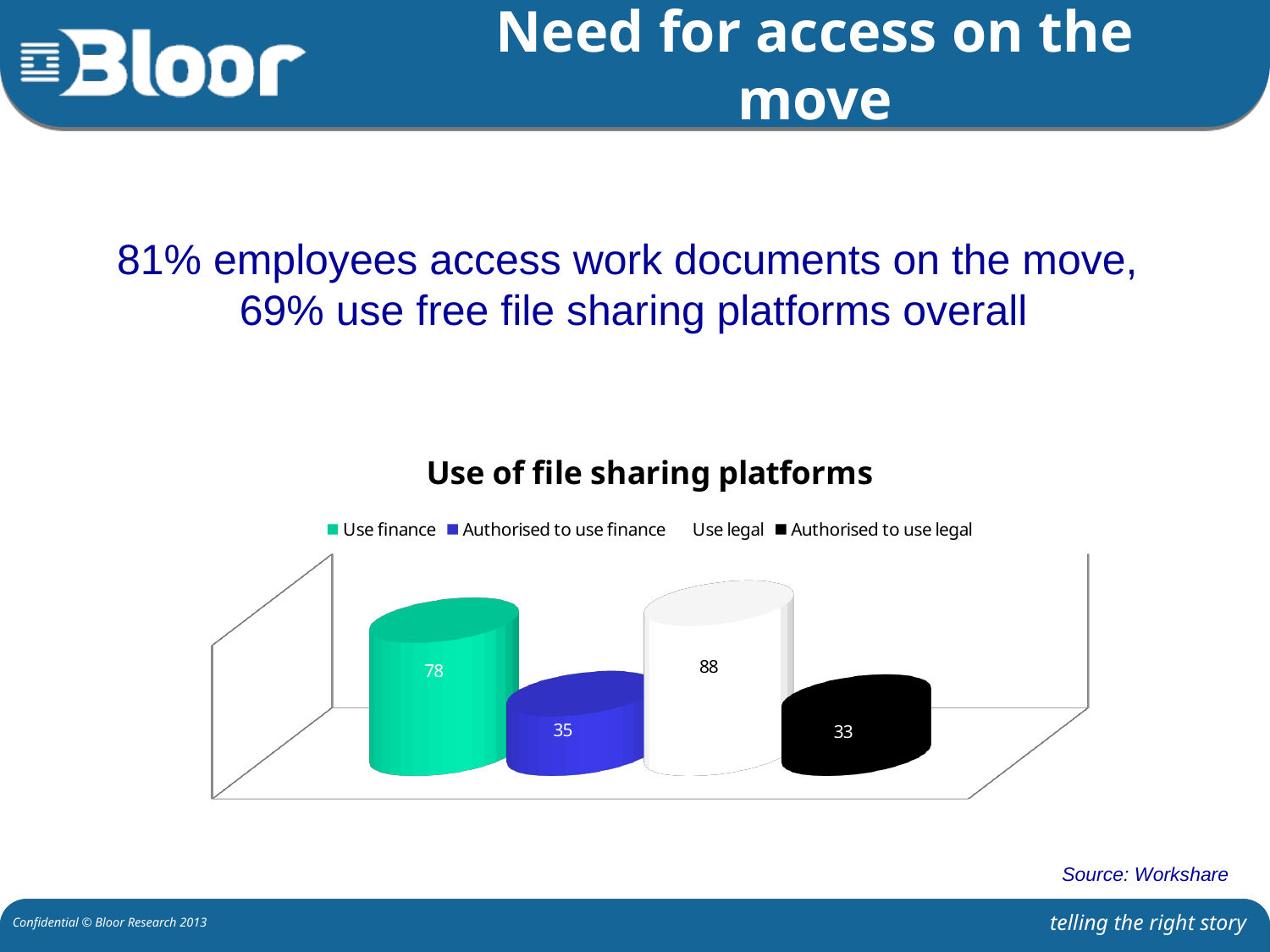
Which series has the highest value? Use legal Which series has the lowest value? Authorised to use legal What is the difference between Use finance and Authorised to use finance? 43 What is the value for Authorised to use finance? 35 What is the difference between Use legal and Use finance? 10 How many series does the legend list? 4 Which is larger, Use finance or Authorised to use finance? Use finance What is the value for Use legal? 88 What is the value for Use finance? 78 What is the title of the chart? Use of file sharing platforms What is the value for Authorised to use legal? 33 What kind of chart is shown? Bar chart